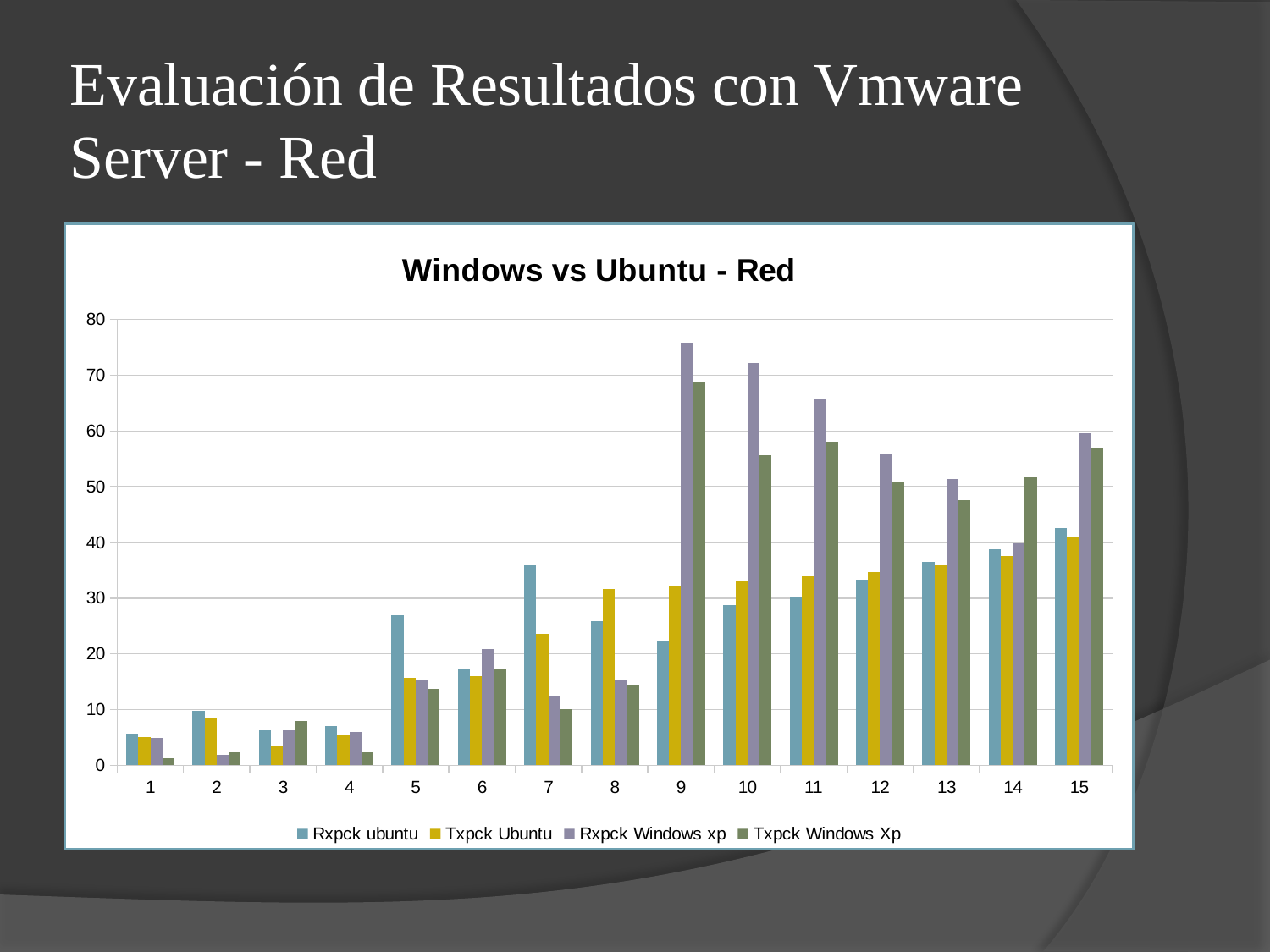
For the Rxpck Windows xp series, which category has the highest value? 9 Is the value for Rxpck Windows xp at category 9 greater or less than 70? greater At category 9, which is larger: Rxpck Windows xp or Rxpck ubuntu? Rxpck Windows xp Is the value for Txpck Windows Xp at category 1 greater or less than 10? less What kind of chart is shown on the slide? bar chart How many series does the legend list? 4 How many categories are shown on the x axis? 15 What is the title of the chart? Windows vs Ubuntu - Red At category 7, which is larger: Rxpck ubuntu or Rxpck Windows xp? Rxpck ubuntu Does the Rxpck Windows xp series rise or fall from category 9 to category 13? fall Is the value for Rxpck ubuntu at category 7 greater or less than 30? greater